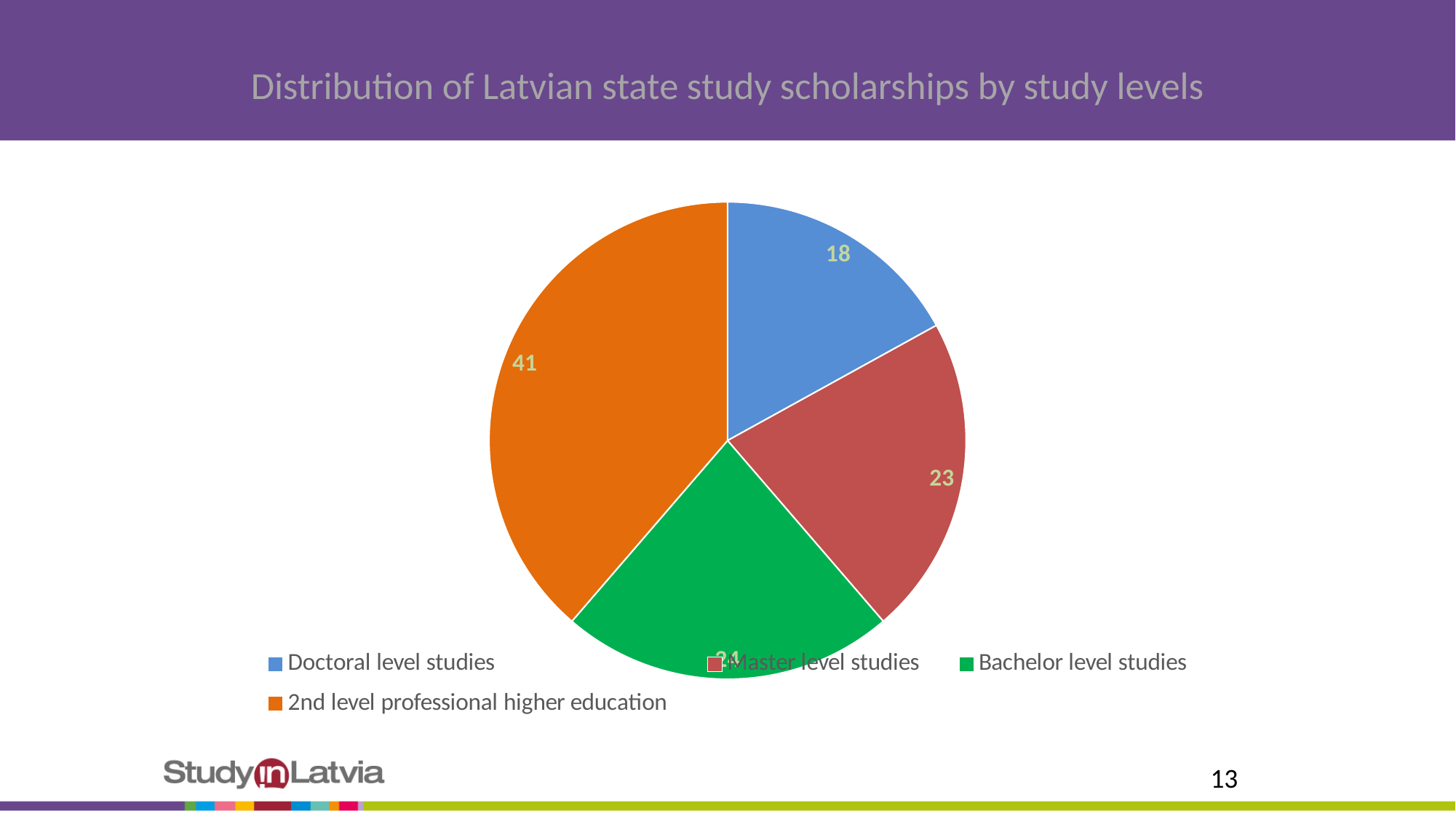
What value is shown for 2nd level professional higher education? 41 What value is shown for Master level studies? 23 Which is larger, the value for Master level studies or for Doctoral level studies? Master level studies What is the difference between the values for 2nd level professional higher education and Doctoral level studies? 23 What type of chart is shown on the slide? Pie chart What is the difference between the values for Master level studies and Doctoral level studies? 5 What value is shown for Doctoral level studies? 18 Which study level has the smallest slice of the pie? Doctoral level studies What is the title of the chart? Distribution of Latvian state study scholarships by study levels What is the difference between the values for 2nd level professional higher education and Master level studies? 18 How many slices does the pie chart have? 4 Which study level has the largest slice of the pie? 2nd level professional higher education